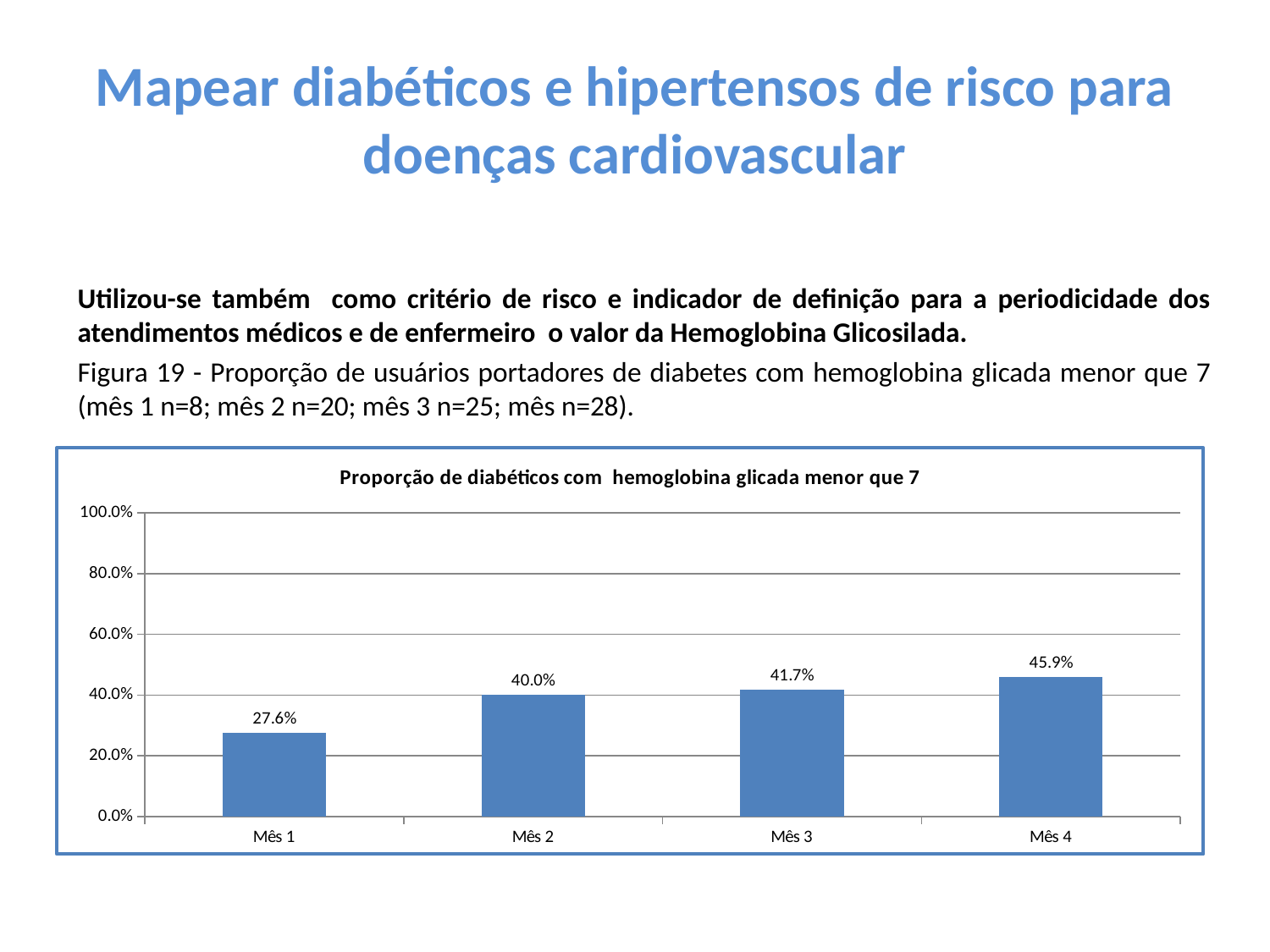
Is the value for Mês 4 greater or less than 60.0%? less What is the value for Mês 4? 45.9% Which month has the lowest value? Mês 1 What is the difference between the values for Mês 2 and Mês 1? 12.4% What is the difference between the values for Mês 4 and Mês 1? 18.3% What is the value for Mês 1? 27.6% What is the value for Mês 3? 41.7% Which month has the highest value? Mês 4 Do the values rise or fall from Mês 1 to Mês 4? rise Which is larger, the value for Mês 2 or the value for Mês 1? Mês 2 How many months are shown on the x axis? 4 What kind of chart is shown? bar chart